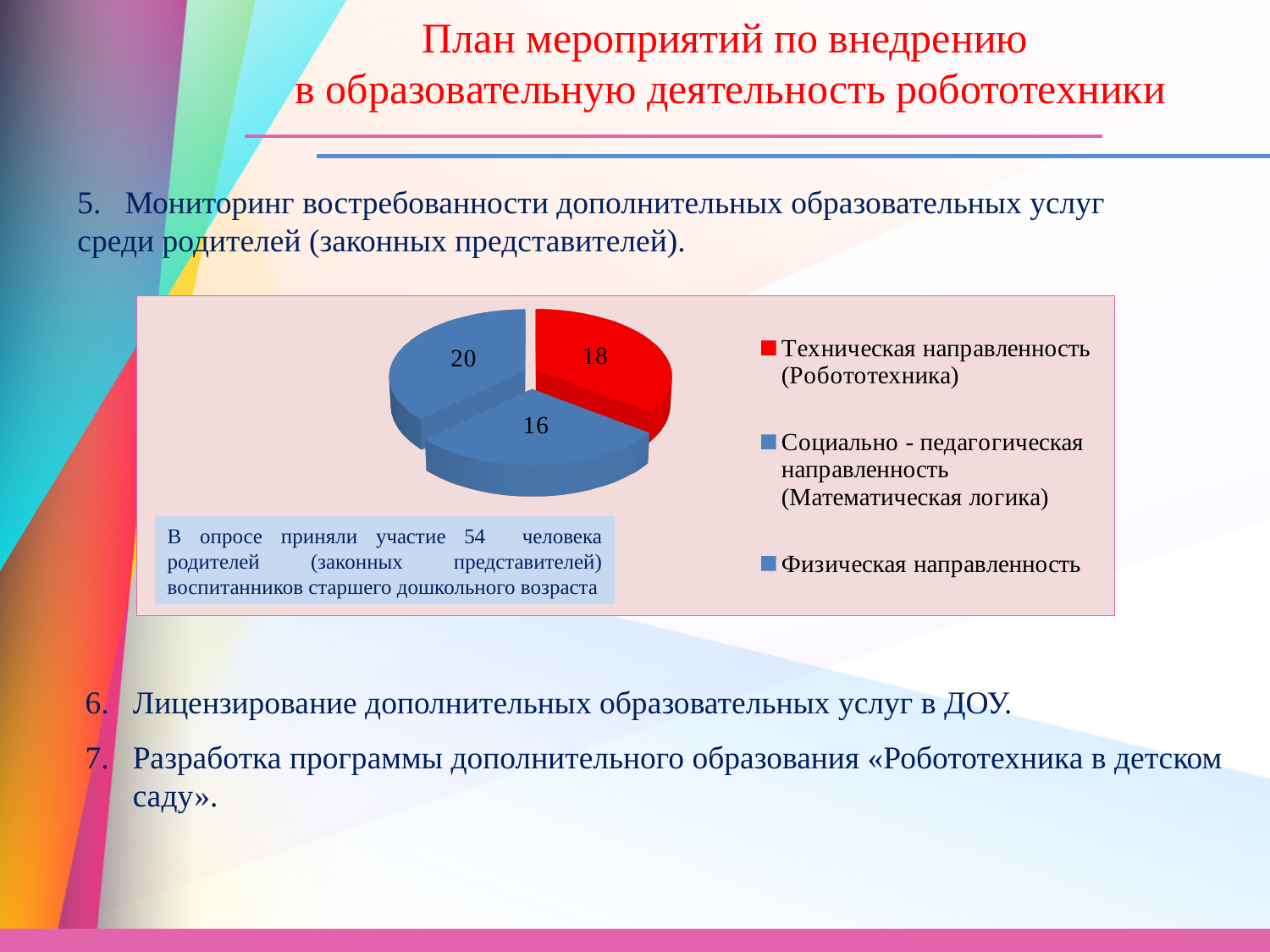
What is the difference between the largest slice (20) and the smallest slice (16)? 4 Which is larger: the slice for Техническая направленность (Робототехника) or the slice for Физическая направленность? Физическая направленность What is the total of all slices in the pie chart? 54 What kind of chart is shown on the slide? pie chart Which category has the largest slice in the pie chart? Физическая направленность What is the value of the slice for Социально - педагогическая направленность (Математическая логика)? 16 Which category has the smallest slice in the pie chart? Социально - педагогическая направленность (Математическая логика) How many entries does the legend of the pie chart list? 3 What is the value of the slice for Техническая направленность (Робототехника)? 18 What is the value of the slice for Физическая направленность? 20 How many slices does the pie chart have? 3 What colour is the slice for Техническая направленность (Робототехника)? red